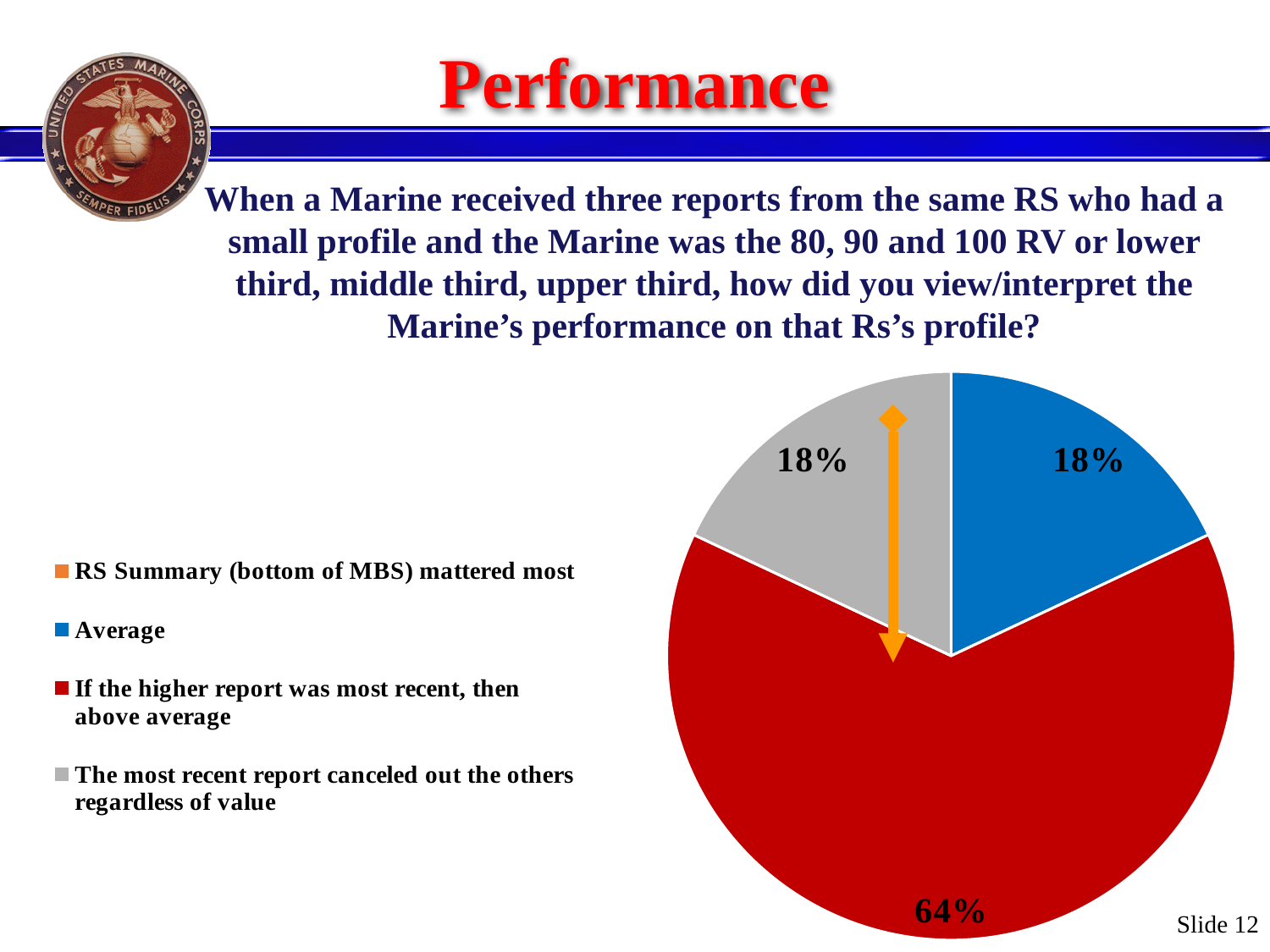
Is the share for 'If the higher report was most recent, then above average' greater or less than 50%? greater Which is larger: the share for 'Average' or the share for 'If the higher report was most recent, then above average'? If the higher report was most recent, then above average What percentage is shown for the slice 'The most recent report canceled out the others regardless of value'? 18% What is the difference in percentage points between the 64% slice and the 'Average' slice? 46 What percentage is shown for the slice 'If the higher report was most recent, then above average'? 64% What kind of chart is shown on the slide? pie chart What colour is the slice representing 'If the higher report was most recent, then above average'? red What percentage of the pie is labelled for the 'Average' slice? 18% Which response has the largest share of the pie? If the higher report was most recent, then above average How many slices with printed percentage labels are visible in the pie? 3 Which legend entry is shown in blue? Average How many entries does the legend list? 4